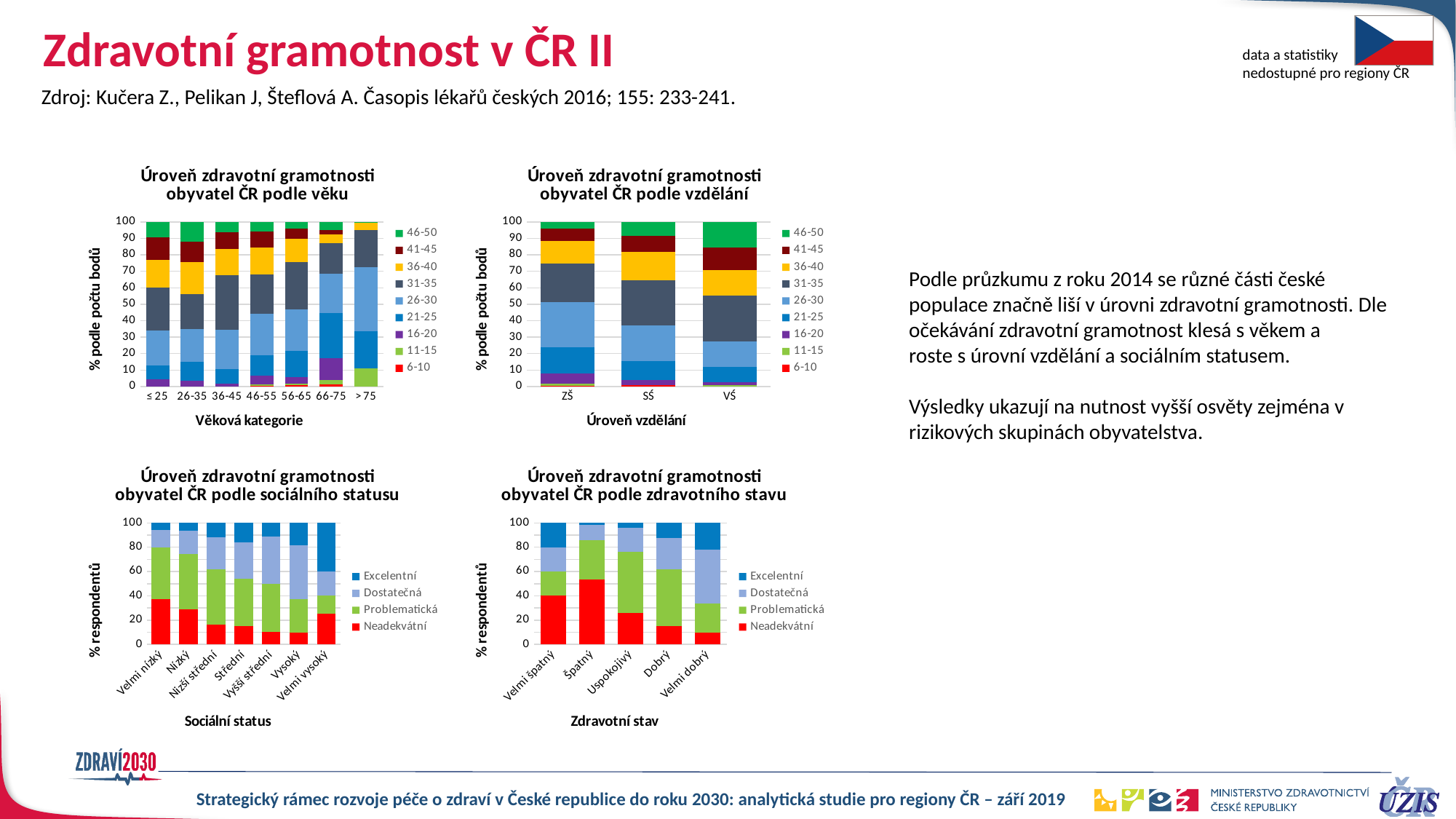
In the chart "Úroveň zdravotní gramotnosti obyvatel ČR podle sociálního statusu", is the Neadekvátní value for Velmi nízký greater or less than 20? greater How many categories are shown on the x axis of the chart "Úroveň zdravotní gramotnosti obyvatel ČR podle zdravotního stavu"? 5 In the chart "Úroveň zdravotní gramotnosti obyvatel ČR podle zdravotního stavu", is the Neadekvátní value for Špatný greater or less than 40? greater In the chart "Úroveň zdravotní gramotnosti obyvatel ČR podle sociálního statusu", which is larger, the Neadekvátní value for Velmi nízký or for Nízký? Velmi nízký How many series does the legend of the chart "Úroveň zdravotní gramotnosti obyvatel ČR podle vzdělání" list? 9 How many series does the legend of the chart "Úroveň zdravotní gramotnosti obyvatel ČR podle sociálního statusu" list? 4 In the chart "Úroveň zdravotní gramotnosti obyvatel ČR podle zdravotního stavu", is the Neadekvátní value for Velmi dobrý greater or less than 20? less What is the x-axis title of the chart "Úroveň zdravotní gramotnosti obyvatel ČR podle sociálního statusu"? Sociální status What kind of chart is "Úroveň zdravotní gramotnosti obyvatel ČR podle věku"? Stacked bar chart In the chart "Úroveň zdravotní gramotnosti obyvatel ČR podle zdravotního stavu", which category has the highest Neadekvátní share? Špatný How many age categories are shown on the x axis of the chart "Úroveň zdravotní gramotnosti obyvatel ČR podle věku"? 7 How many categories are shown on the x axis of the chart "Úroveň zdravotní gramotnosti obyvatel ČR podle vzdělání"? 3